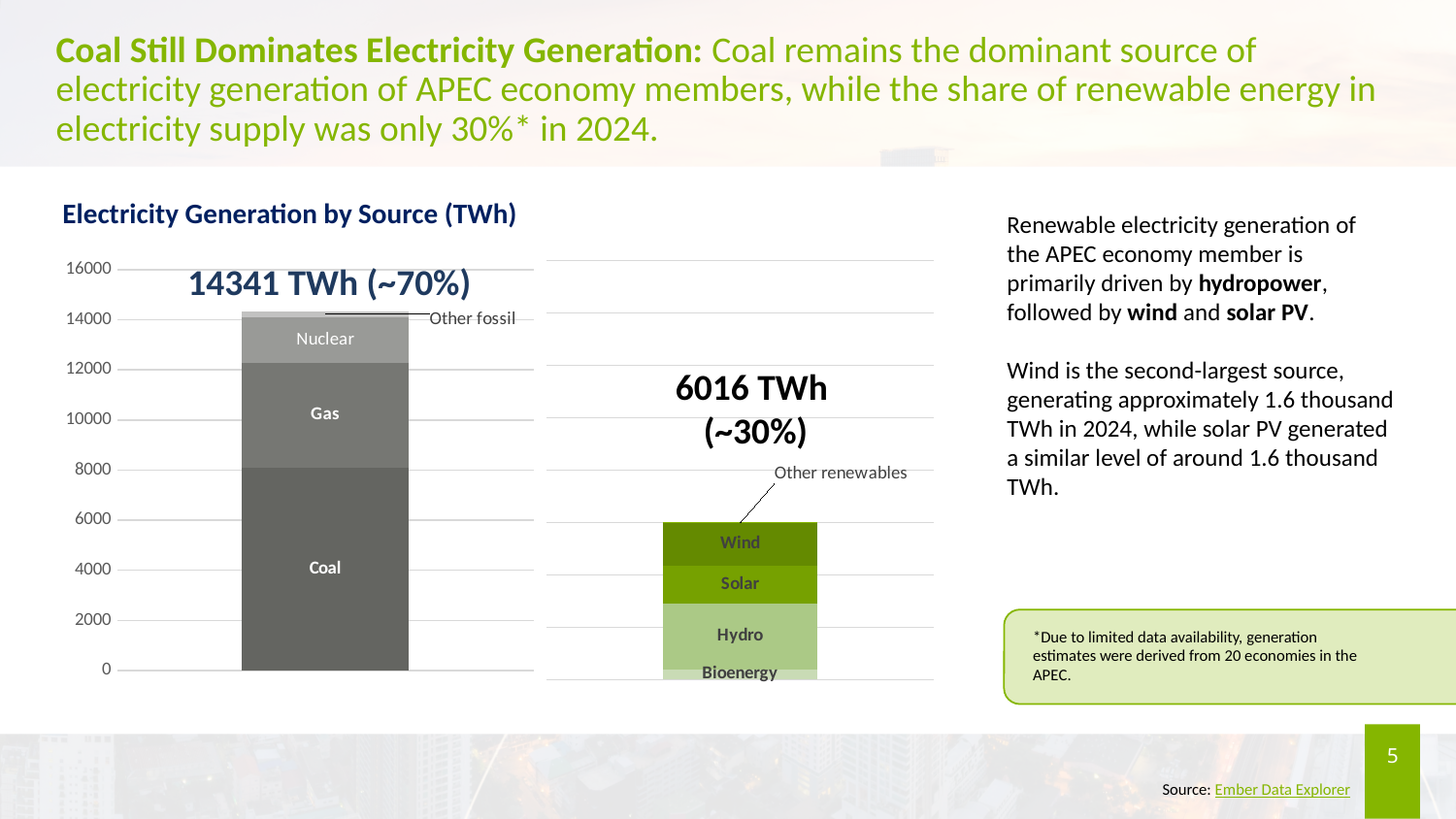
What is the difference between the fossil-fuel bar total (14341 TWh) and the renewables bar total (6016 TWh)? 8325 TWh Is the value for the renewables bar greater or less than 8000? less What is the title of the chart? Electricity Generation by Source (TWh) Which bar is larger, the fossil-fuel bar or the renewables bar? The fossil-fuel bar What is the total value labelled on the renewables bar? 6016 TWh Which segment is the largest in the fossil-fuel bar? Coal Which segment is the largest in the renewables bar? Hydro What kind of chart is shown on the slide? Stacked bar chart What approximate share is printed next to the renewables bar total? ~30% What is the total value labelled on the fossil-fuel bar (Coal, Gas, Nuclear, Other fossil)? 14341 TWh Which segment is the smallest in the fossil-fuel bar? Other fossil How many segments are labelled in the renewables bar? 5